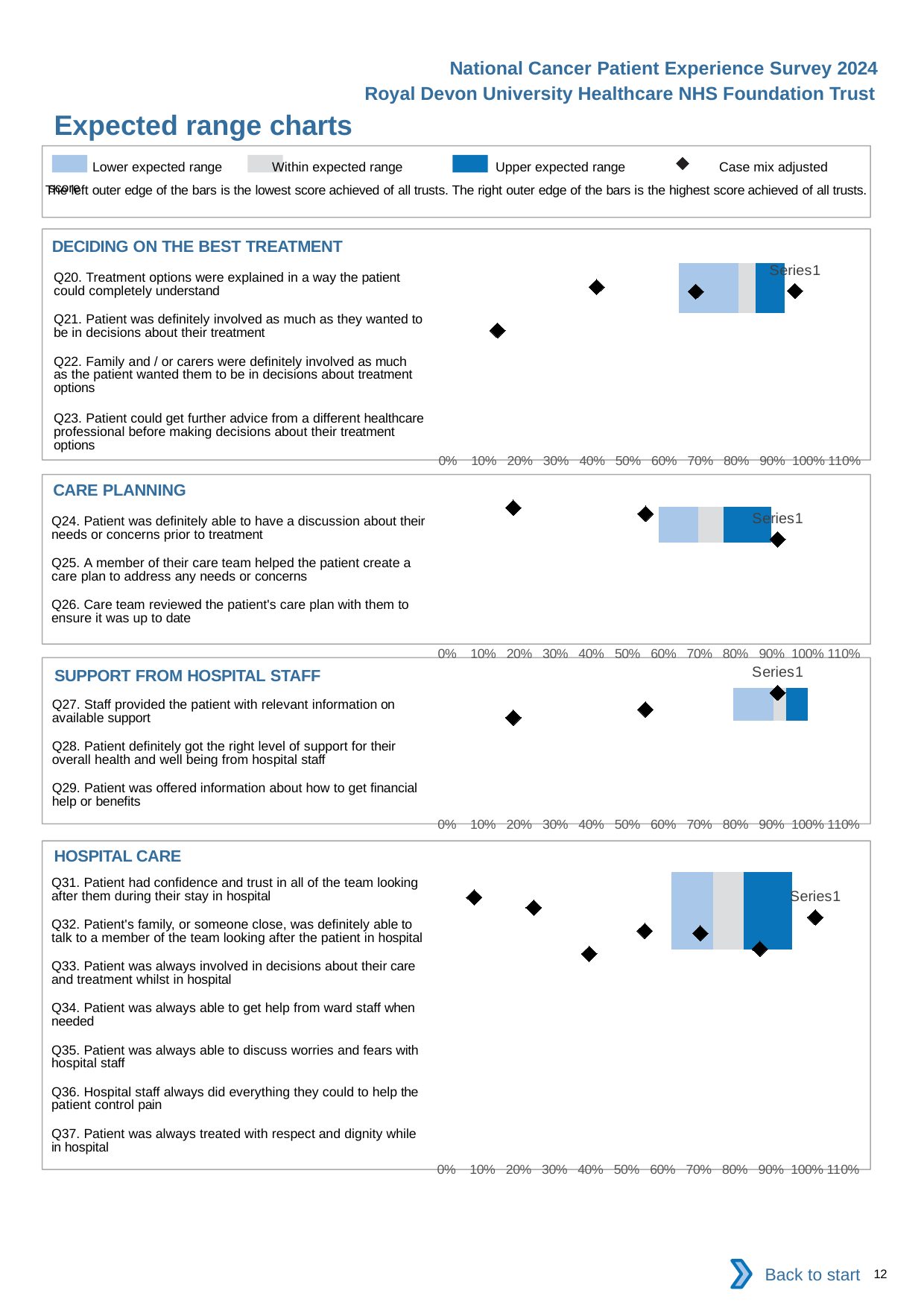
In the 'Support from hospital staff' chart, is the left edge of the expected range bar greater or less than 60%? greater In the 'Care planning' chart, is the left edge of the expected range bar greater or less than 40%? greater In the 'Hospital care' chart, is the left edge of the expected range bar greater or less than 50%? greater In the 'Support from hospital staff' chart, how many questions are listed? 3 In the 'Hospital care' chart, how many questions are listed? 7 How many entries does the legend at the top of the slide list? 4 In the 'Care planning' chart, how many questions are listed? 3 Which colour in the legend represents the upper expected range? Dark blue What is the highest tick shown on the x axis of the charts? 110%